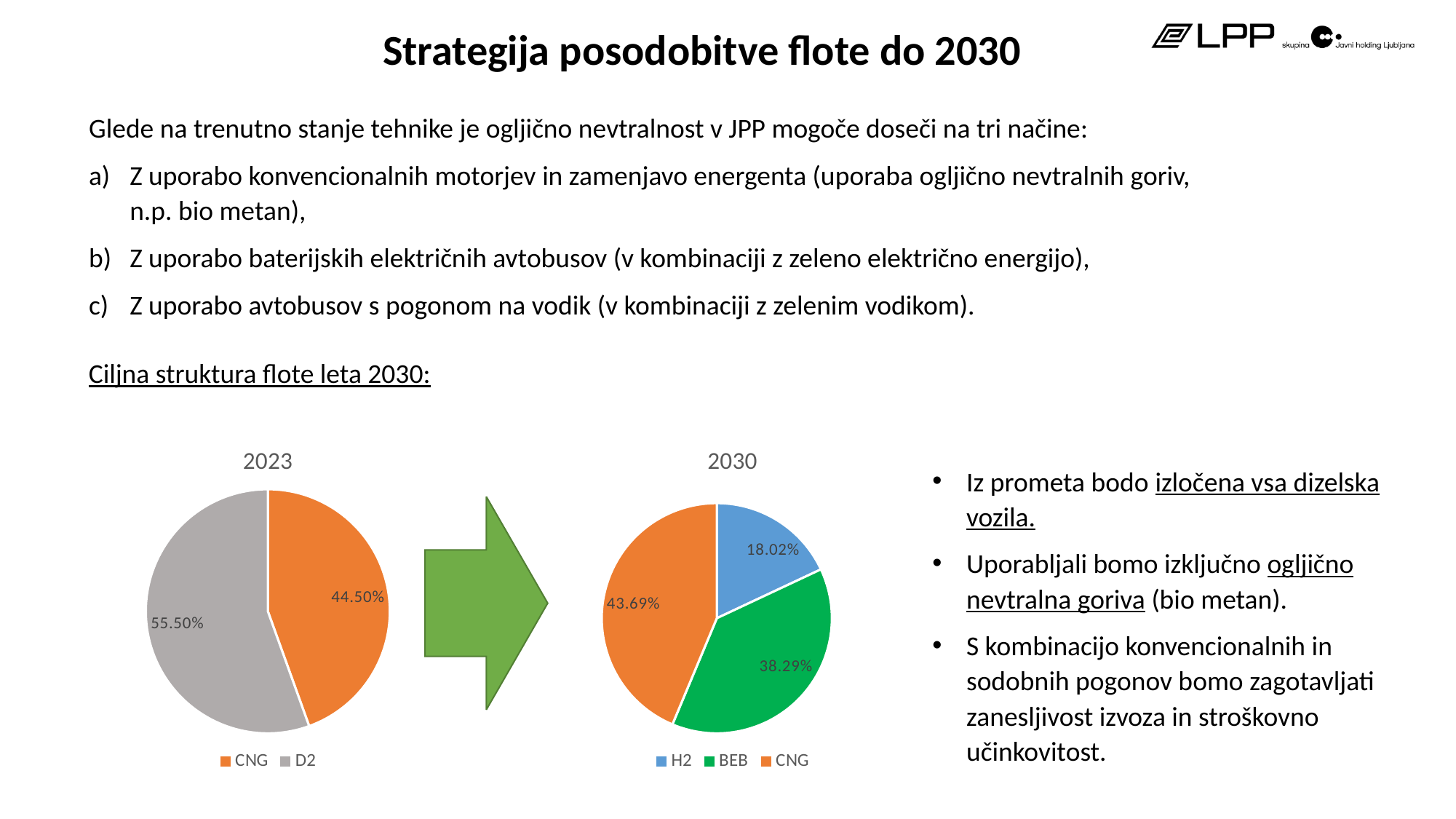
In the 2023 pie chart, what is the difference between the D2 and CNG shares? 11.00% In the 2023 pie chart, which is larger, CNG or D2? D2 In the 2030 pie chart, which category has the largest share? CNG In the 2030 pie chart, what share does BEB have? 38.29% Which legend entries does the 2030 chart list? H2, BEB, CNG In the 2030 pie chart, what share does H2 have? 18.02% In the 2030 pie chart, what share does CNG have? 43.69% In the 2030 pie chart, which category has the smallest share? H2 How many categories does the 2030 pie chart show? 3 What type of chart is the 2023 chart? Pie chart In the 2023 pie chart, what share does D2 have? 55.50% In the 2023 pie chart, what share does CNG have? 44.50%